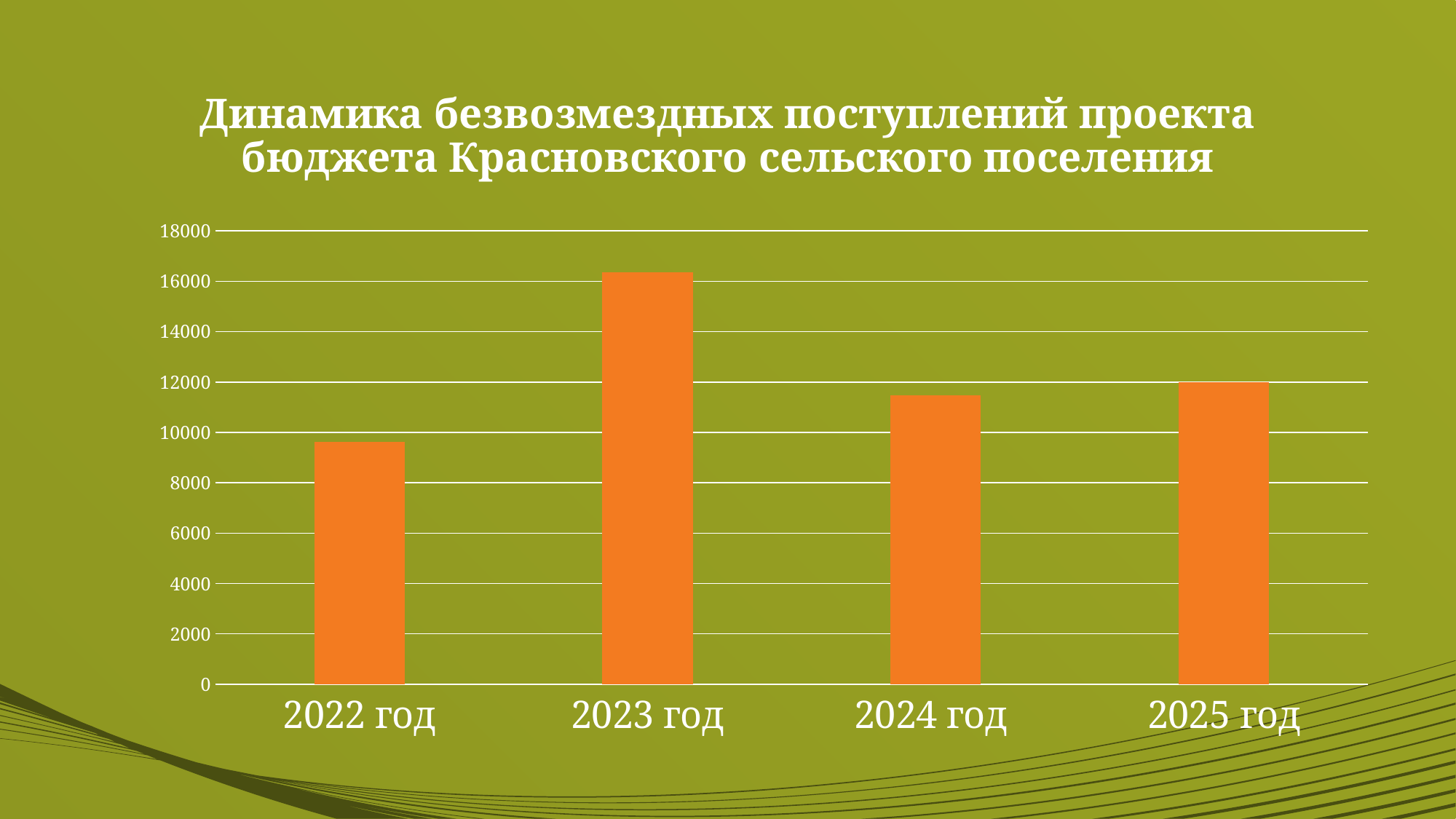
Which is larger, the value for 2023 год or the value for 2025 год? 2023 год Is the value for 2025 год greater or less than 10000? greater How many years (categories) are shown on the x axis of the chart? 4 Is the value for 2023 год greater or less than 14000? greater What kind of chart is shown on the slide? bar chart Which is larger, the value for 2022 год or the value for 2024 год? 2024 год Which year has the highest value in the chart? 2023 год Is the value for 2024 год greater or less than 12000? less Which year has the lowest value in the chart? 2022 год What is the title of the chart? Динамика безвозмездных поступлений проекта бюджета Красновского сельского поселения Does the value rise or fall from 2023 год to 2024 год? fall